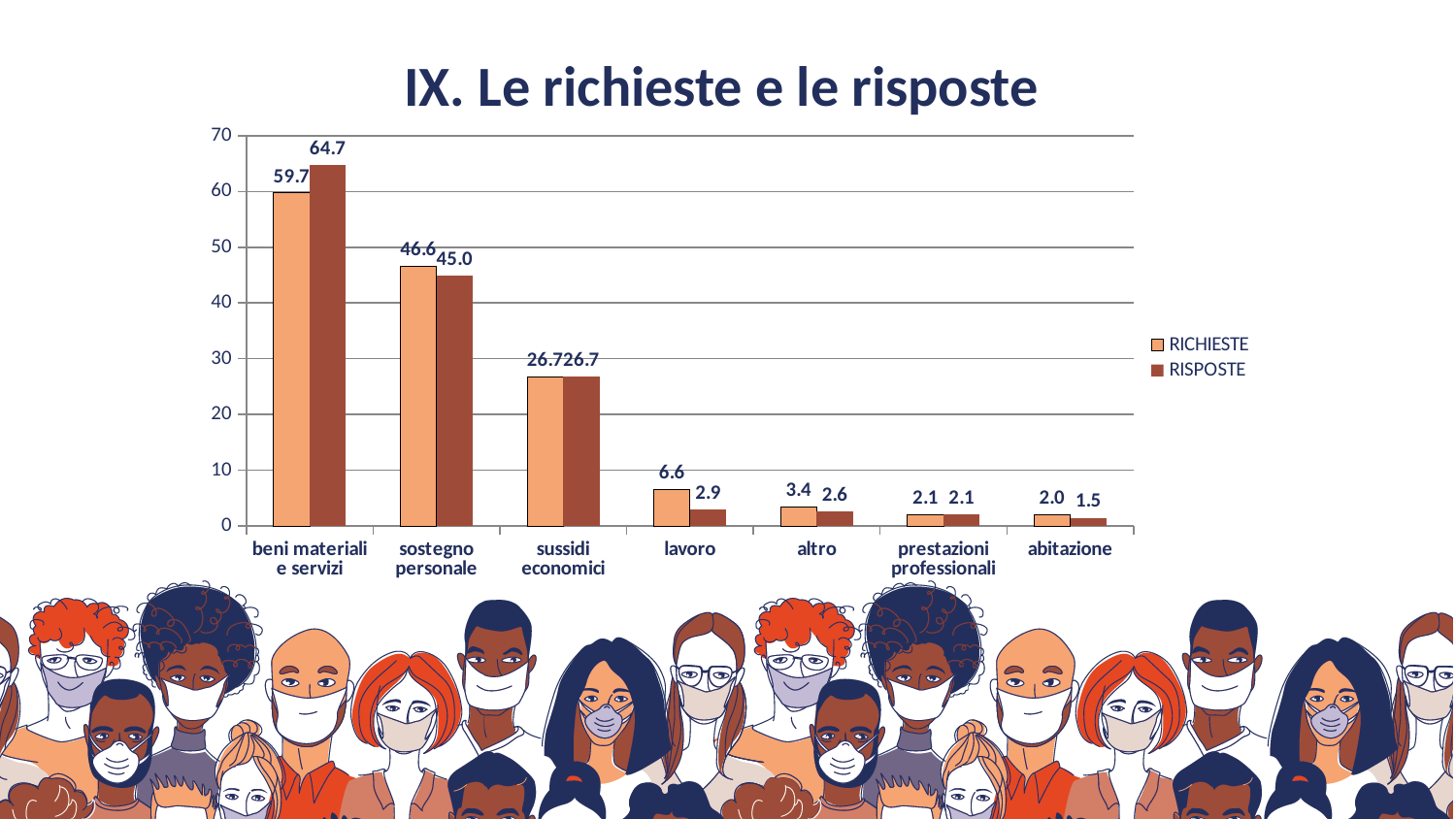
Is the RICHIESTE value for sussidi economici greater or less than 30? less Which category has the lowest RICHIESTE value? abitazione What is the RISPOSTE value for sostegno personale? 45.0 What is the RISPOSTE value for lavoro? 2.9 How many series does the legend list? 2 Which is larger for sostegno personale, RICHIESTE or RISPOSTE? RICHIESTE Which category has the highest RISPOSTE value? beni materiali e servizi How many categories are shown on the x axis? 7 What is the title of the slide? IX. Le richieste e le risposte What is the RICHIESTE value for beni materiali e servizi? 59.7 What is the difference between the RISPOSTE and RICHIESTE values for beni materiali e servizi? 5.0 What kind of chart is shown on the slide? bar chart